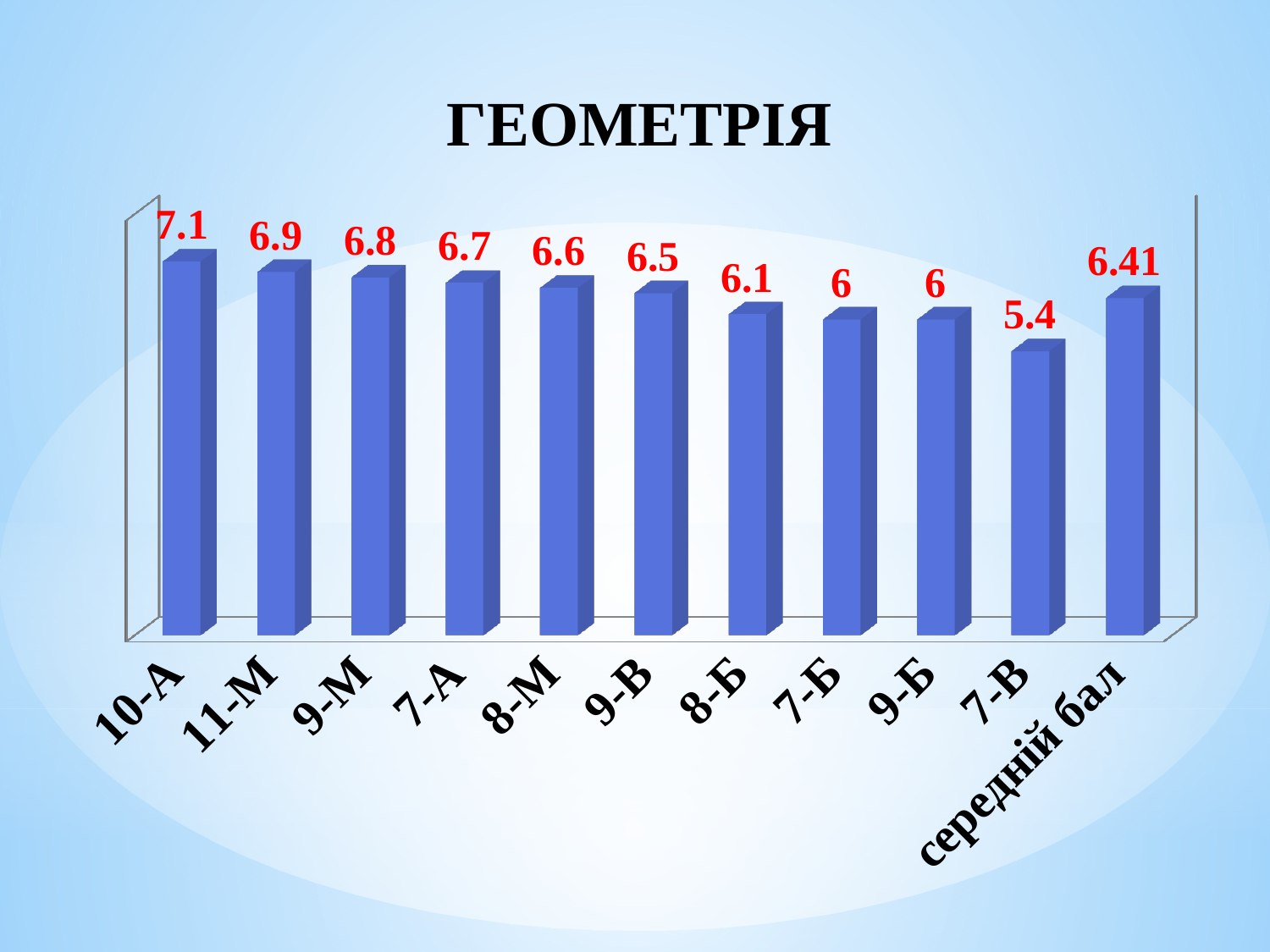
What is the value for середній бал? 6.41 What kind of chart is this? bar chart Which category has the lowest value? 7-В How many categories are shown on the x axis? 11 Do the values rise or fall from 10-А to 7-В along the x axis? fall What is the difference between the values for 10-А and 7-В? 1.7 What is the title of the chart? ГЕОМЕТРІЯ What is the value for 8-Б? 6.1 What is the value for 10-А? 7.1 Which category has the highest value? 10-А What is the value for 7-В? 5.4 Which is larger, the value for 11-М or the value for 9-В? 11-М